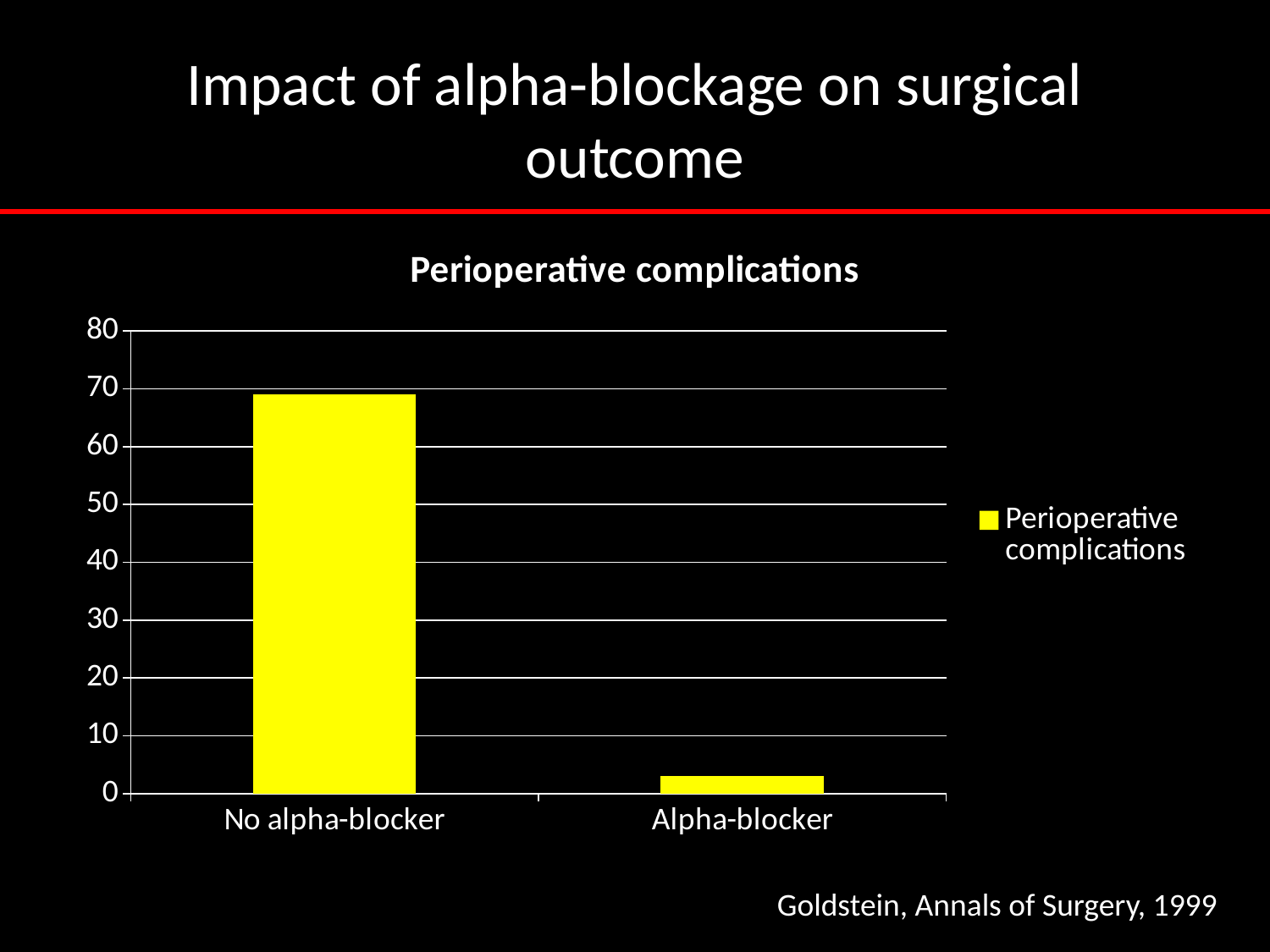
Is the value for Alpha-blocker greater or less than 10? less What is the title of the chart? Perioperative complications Is the value for No alpha-blocker greater or less than 80? less Which category has the highest value for perioperative complications? No alpha-blocker What kind of chart is shown on the slide? Bar chart Do the values rise or fall moving from No alpha-blocker to Alpha-blocker along the x axis? fall Which category has the lowest value for perioperative complications? Alpha-blocker Which is larger, the value for No alpha-blocker or the value for Alpha-blocker? No alpha-blocker How many series does the chart's legend list? 1 How many categories are shown on the x axis of the chart? 2 What colour are the bars in the chart? Yellow Is the value for No alpha-blocker greater or less than 60? greater